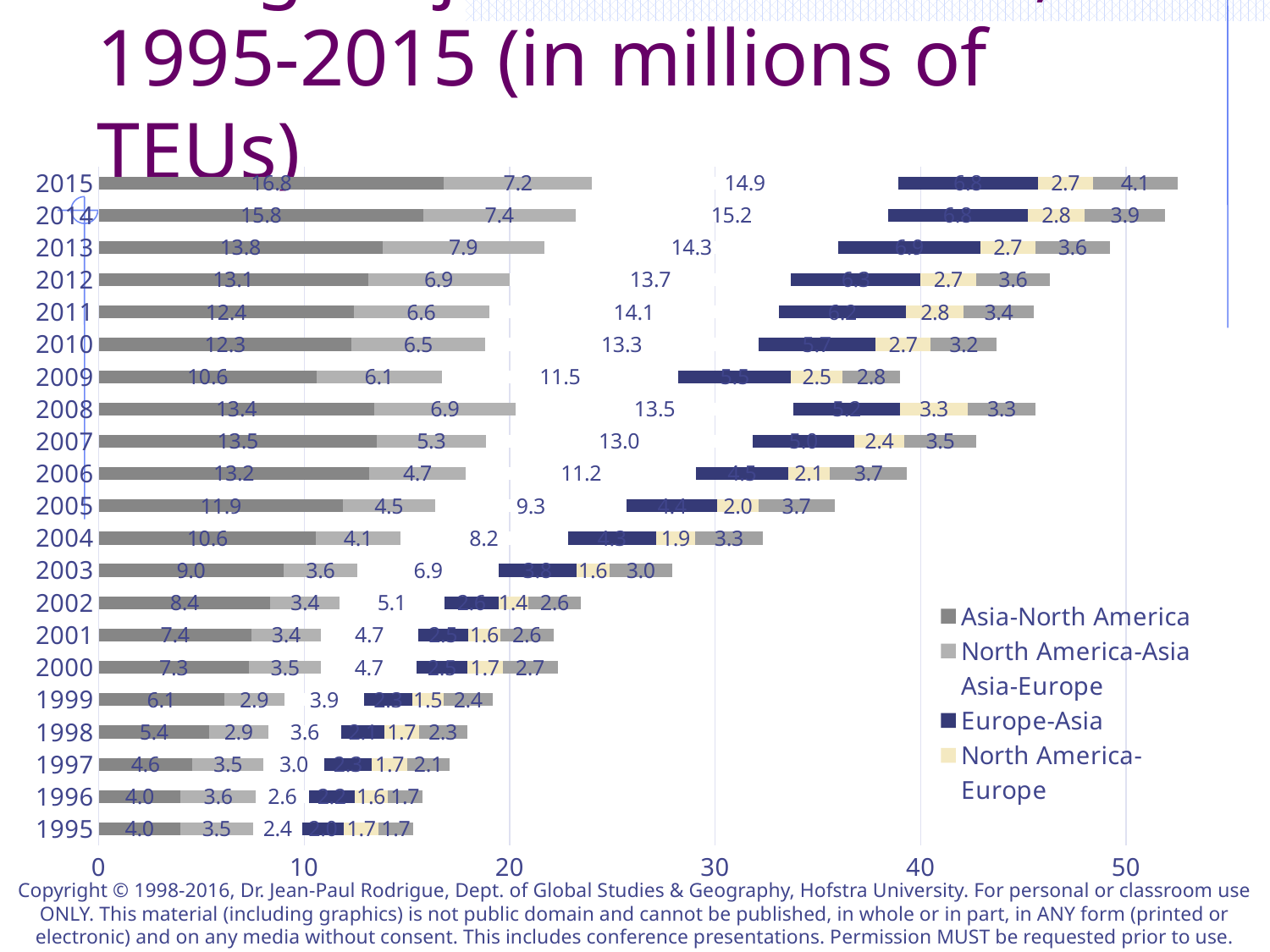
Which year has the highest Asia-North America value? 2015 What is the Asia-North America value for 1995? 4.0 What kind of chart is shown on the slide? Stacked bar chart How many years are shown on the chart? 21 What is the Asia-Europe value for 2009? 11.5 Which year has the larger Asia-Europe value, 2008 or 2009? 2008 Which year has the lowest Asia-Europe value? 1995 By how much did the Asia-North America value change from 2014 to 2015? 1.0 What is the North America-Asia value for 2015? 7.2 What is the Asia-Europe value for 2014? 15.2 What is the Asia-North America value for 2015? 16.8 What is the North America-Europe value for 2008? 3.3